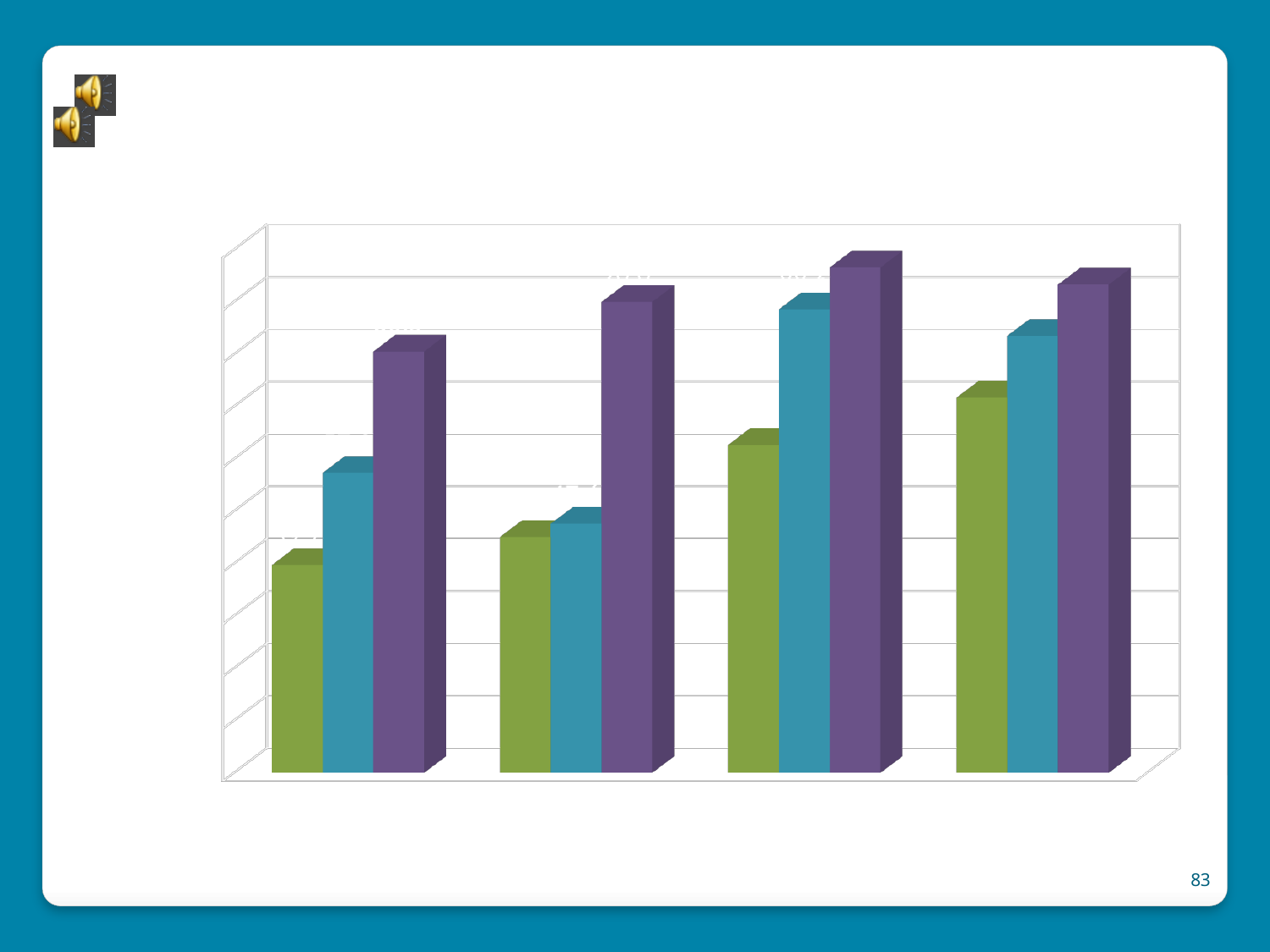
In the second group from the left, is the blue bar or the purple bar taller? purple Which colour bar is the shortest in every group? green Do the green bars rise or fall from left to right across the groups? rise How many bars are there in each group? 3 Which group from the left has the shortest blue bar? the second group Which group from the left has the shortest green bar? the first group Which colour bar is the tallest in every group? purple What kind of chart is shown on the slide? bar chart Which group from the left has the tallest purple bar? the third group How many groups of bars does the chart show? 4 In the first group from the left, is the purple bar or the green bar taller? purple